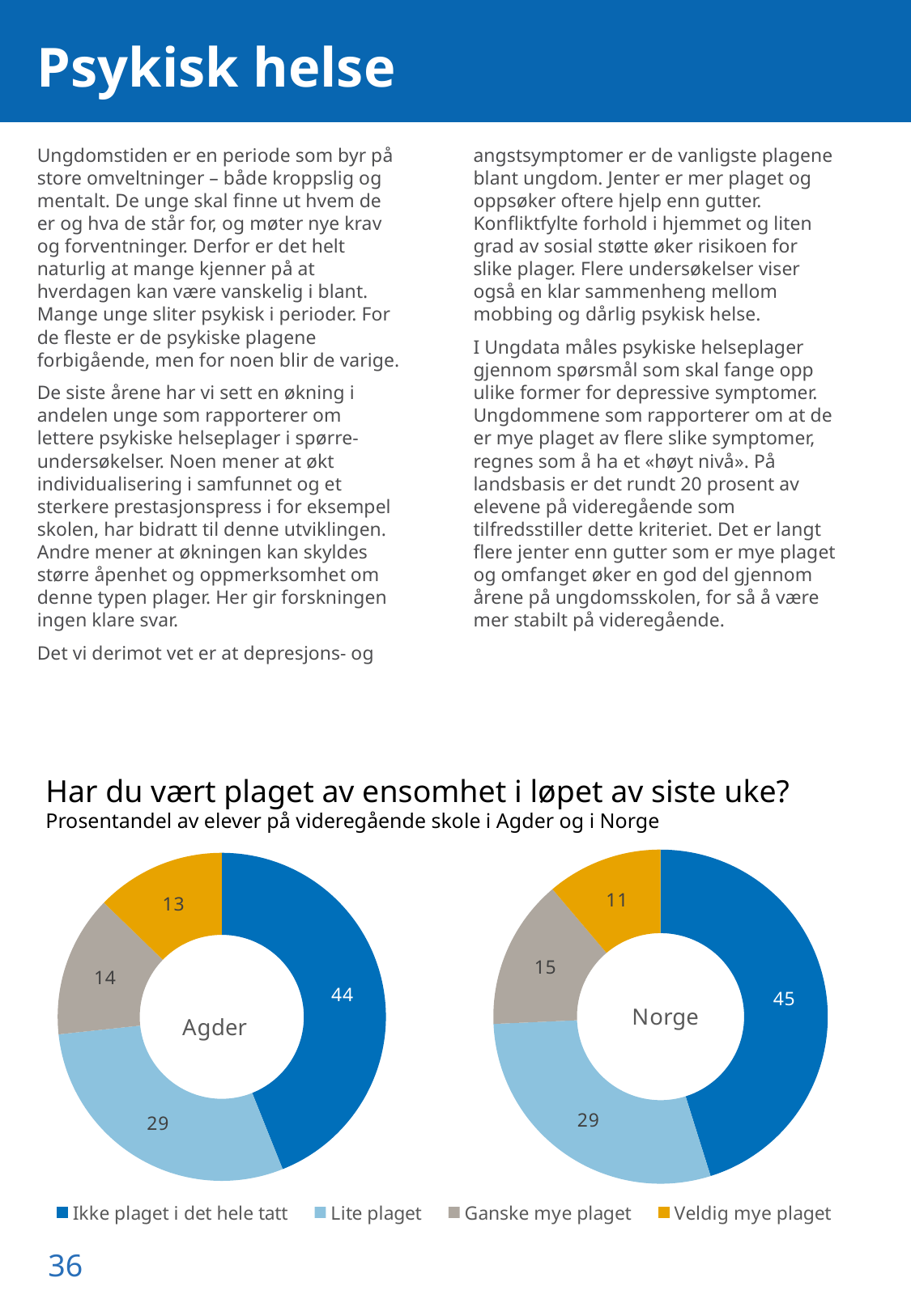
What is the difference between the "Ikke plaget i det hele tatt" values in the Norge chart and the Agder chart? 1 In the Agder chart, which category has the largest share? Ikke plaget i det hele tatt Which is larger: "Veldig mye plaget" in the Agder chart or in the Norge chart? Agder How many entries does the legend list? 4 What is the title of the chart section on the slide? Har du vært plaget av ensomhet i løpet av siste uke? In the Agder chart, what is the value for "Ganske mye plaget"? 14 What kind of chart is used to show the Agder and Norge data? Donut (pie) chart In the Norge chart, what is the value for "Lite plaget"? 29 How many categories does each donut chart show? 4 In the Norge chart, what percentage of students answered "Veldig mye plaget"? 11 In the Agder chart, what percentage of students answered "Ikke plaget i det hele tatt"? 44 In the Norge chart, which category has the smallest share? Veldig mye plaget